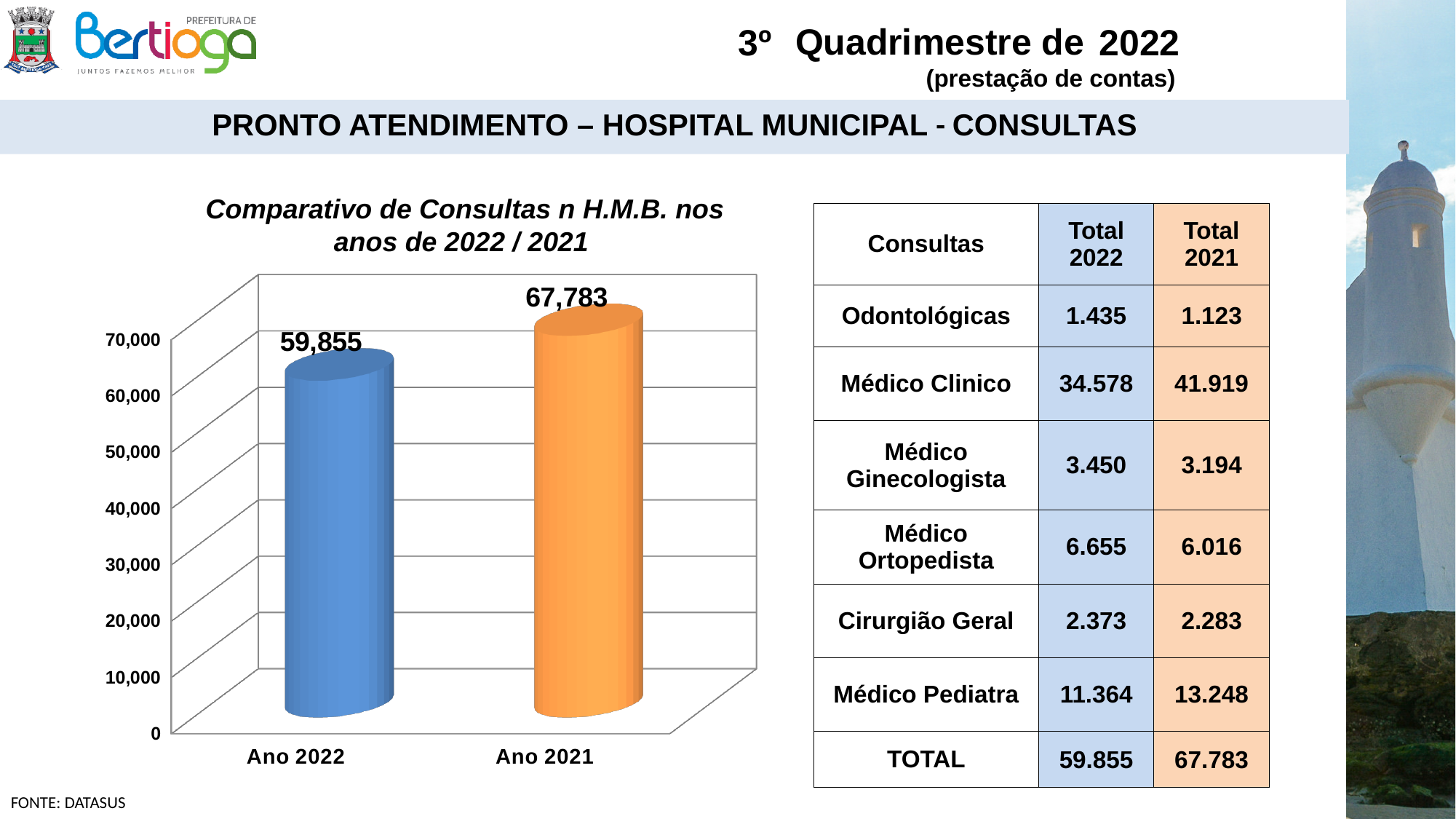
What is the value shown for Ano 2022? 59,855 Is the value for Ano 2022 larger or smaller than the value for Ano 2021? smaller Which category has the lower value in the chart? Ano 2022 Is the value for Ano 2021 greater or less than 60,000? greater Which category has the higher value, Ano 2022 or Ano 2021? Ano 2021 Is the value for Ano 2022 greater or less than 60,000? less How many categories are plotted in the chart? 2 What is the difference between the values for Ano 2021 and Ano 2022? 7,928 What colour is the bar for Ano 2021? orange What kind of chart is shown on the slide? bar chart What is the value shown for Ano 2021? 67,783 What is the title of the chart? Comparativo de Consultas n H.M.B. nos anos de 2022 / 2021